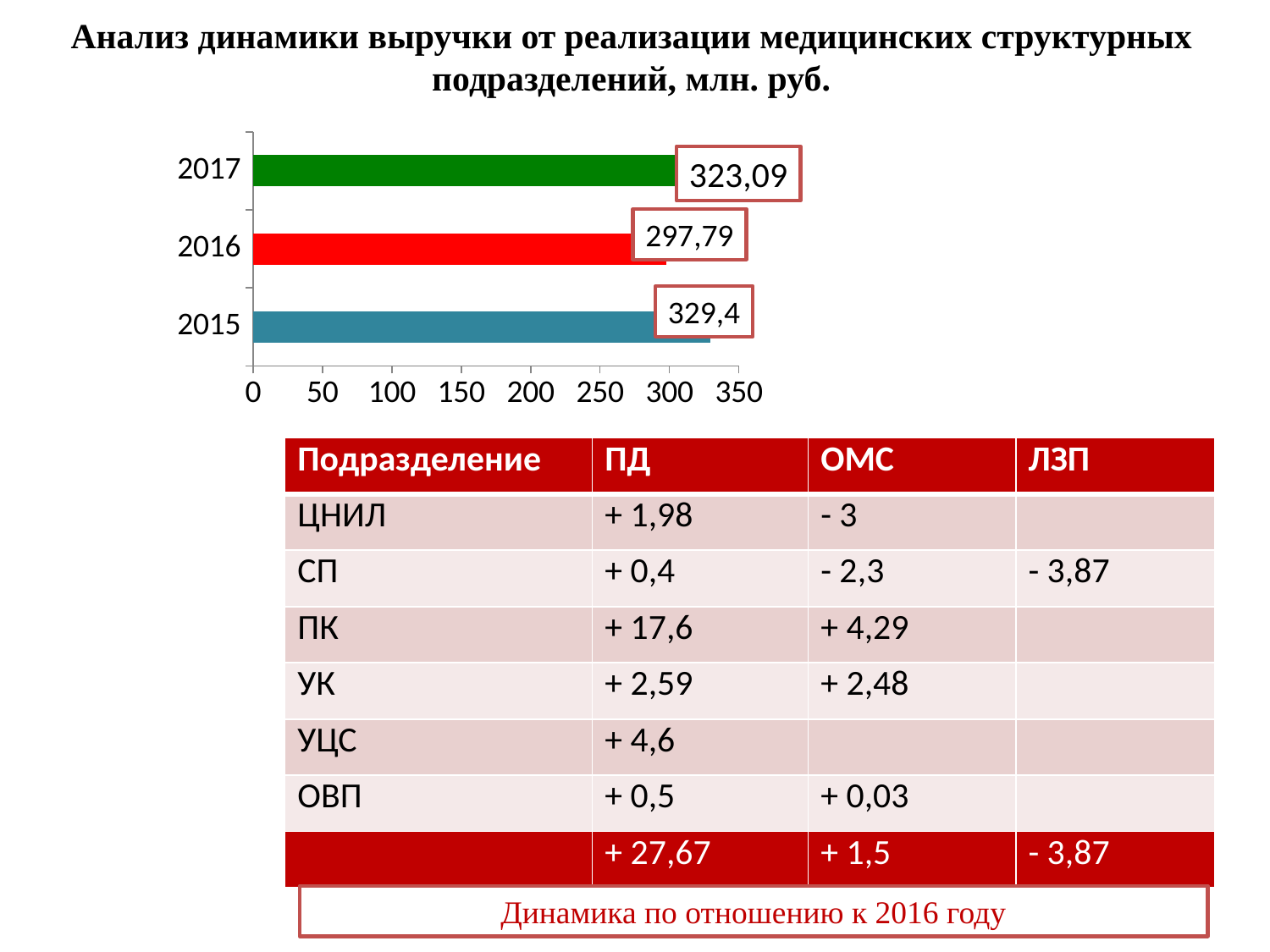
What is the difference between the revenue for 2015 and 2016? 31,61 What is the difference between the revenue for 2017 and 2016? 25,3 Which year has the lowest revenue in the chart? 2016 Is the value for 2016 greater or less than 300? less What is the revenue value shown for 2017? 323,09 Which year has the highest revenue in the chart? 2015 What colour is the bar for 2017? green What is the revenue value shown for 2015? 329,4 Which year has the larger revenue, 2016 or 2017? 2017 What kind of chart is shown on the slide? bar chart What is the revenue value shown for 2016? 297,79 How many years are shown in the chart? 3